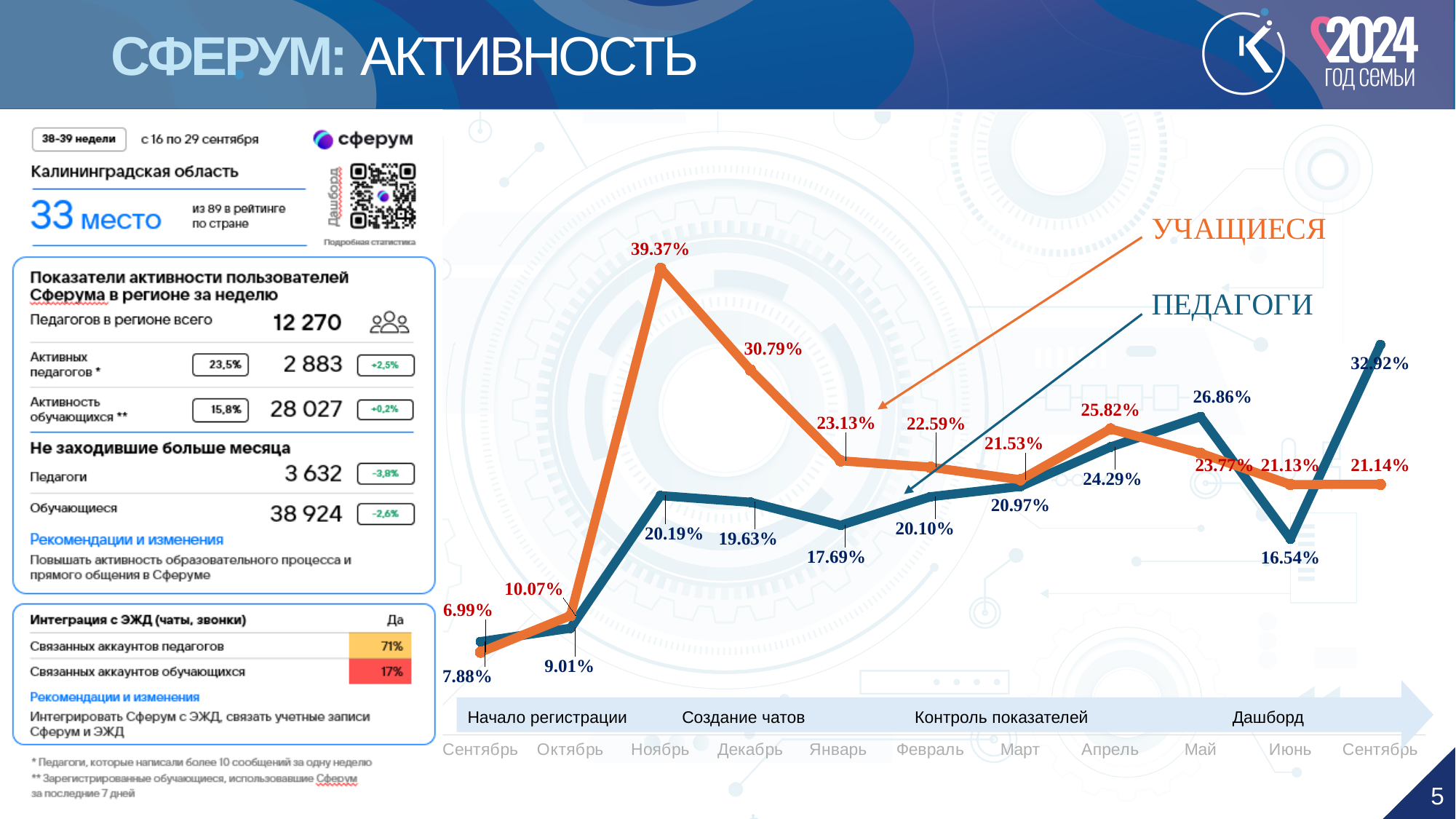
How many series does the chart show? 2 What kind of chart is shown on the slide? line chart Which series has the larger value in Январь, УЧАЩИЕСЯ or ПЕДАГОГИ? УЧАЩИЕСЯ What is the value for УЧАЩИЕСЯ in Ноябрь? 39.37% What is the value for ПЕДАГОГИ in Июнь? 16.54% How many months are shown on the x axis of the chart? 11 In which month does the ПЕДАГОГИ series have its lowest value? Сентябрь (first) Does the ПЕДАГОГИ series rise or fall from Май to Июнь? fall Which series has the larger value in the final Сентябрь point, УЧАЩИЕСЯ or ПЕДАГОГИ? ПЕДАГОГИ What is the value for ПЕДАГОГИ in Май? 26.86% In which month does the УЧАЩИЕСЯ series reach its highest value? Ноябрь What is the difference between the УЧАЩИЕСЯ values in Ноябрь and Декабрь? 8.58%